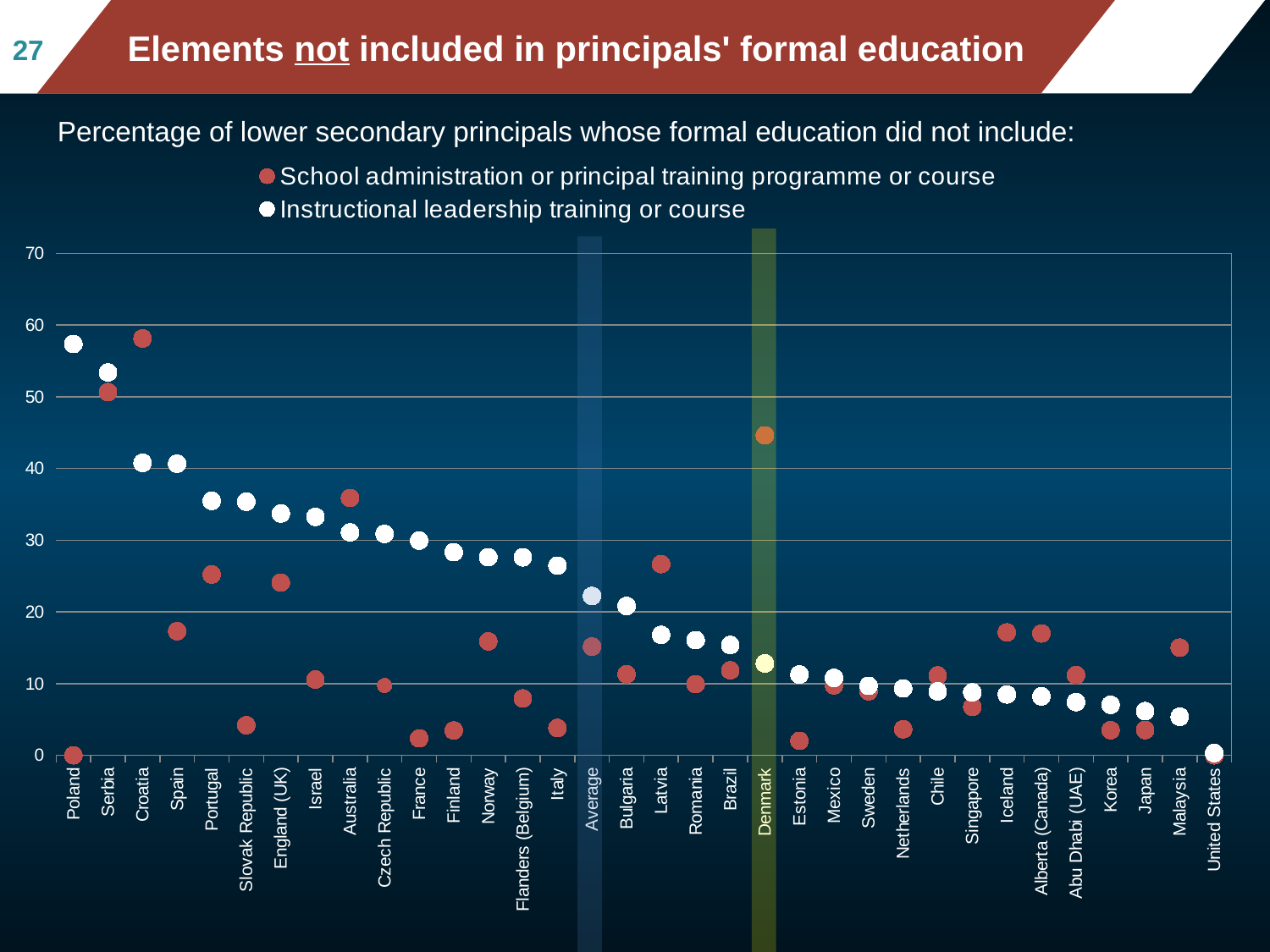
How many countries/economies (including the Average) are shown along the x axis? 34 How many series does the legend list? 2 Is the value for Denmark in the 'School administration or principal training programme or course' series greater or less than 40? greater Do the values for 'Instructional leadership training or course' rise or fall moving from left to right along the x axis? fall Is the value for Average in the 'School administration or principal training programme or course' series greater or less than 20? less Which category has the highest value for 'School administration or principal training programme or course'? Croatia Is the value for Estonia in the 'School administration or principal training programme or course' series greater or less than 10? less Which category has the lowest value for 'Instructional leadership training or course'? United States For Denmark, which series has the larger value: 'School administration or principal training programme or course' or 'Instructional leadership training or course'? School administration or principal training programme or course What kind of chart is shown on the slide? Dot (scatter) chart Which category has the highest value for 'Instructional leadership training or course'? Poland